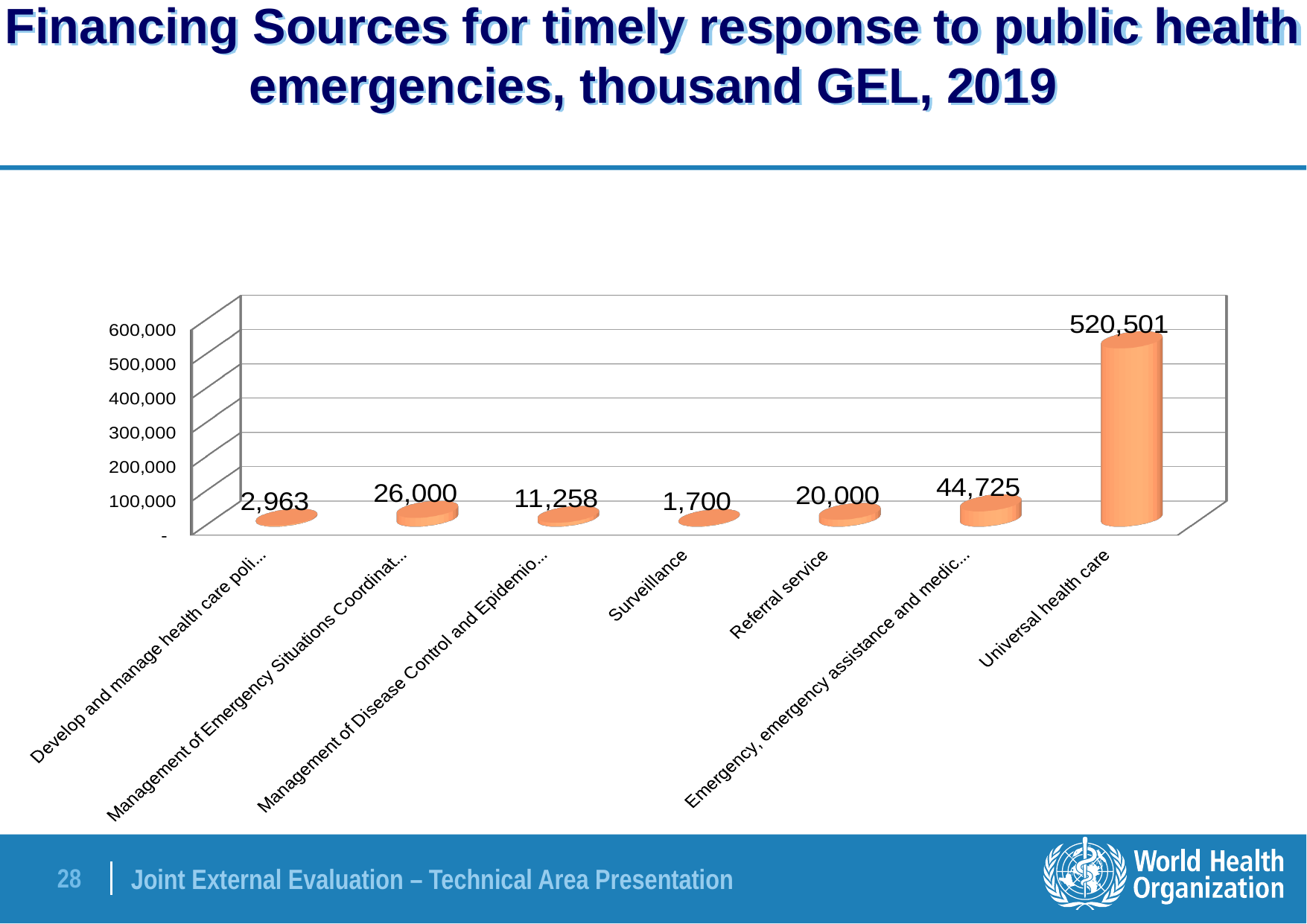
What is the value for the category labelled 'Emergency, emergency assistance and medic...'? 44,725 What is the value for Universal health care? 520,501 Is the value for Universal health care greater or less than 500,000? greater What kind of chart is shown on the slide? bar chart Which is larger, the value for Referral service or the value for Surveillance? Referral service What is the difference between the values for Universal health care and Referral service? 500,501 What is the difference between the values for Referral service and Surveillance? 18,300 What is the value for Referral service? 20,000 How many categories are shown on the chart? 7 Which category has the lowest value? Surveillance What is the value for Surveillance? 1,700 Which category has the highest value? Universal health care